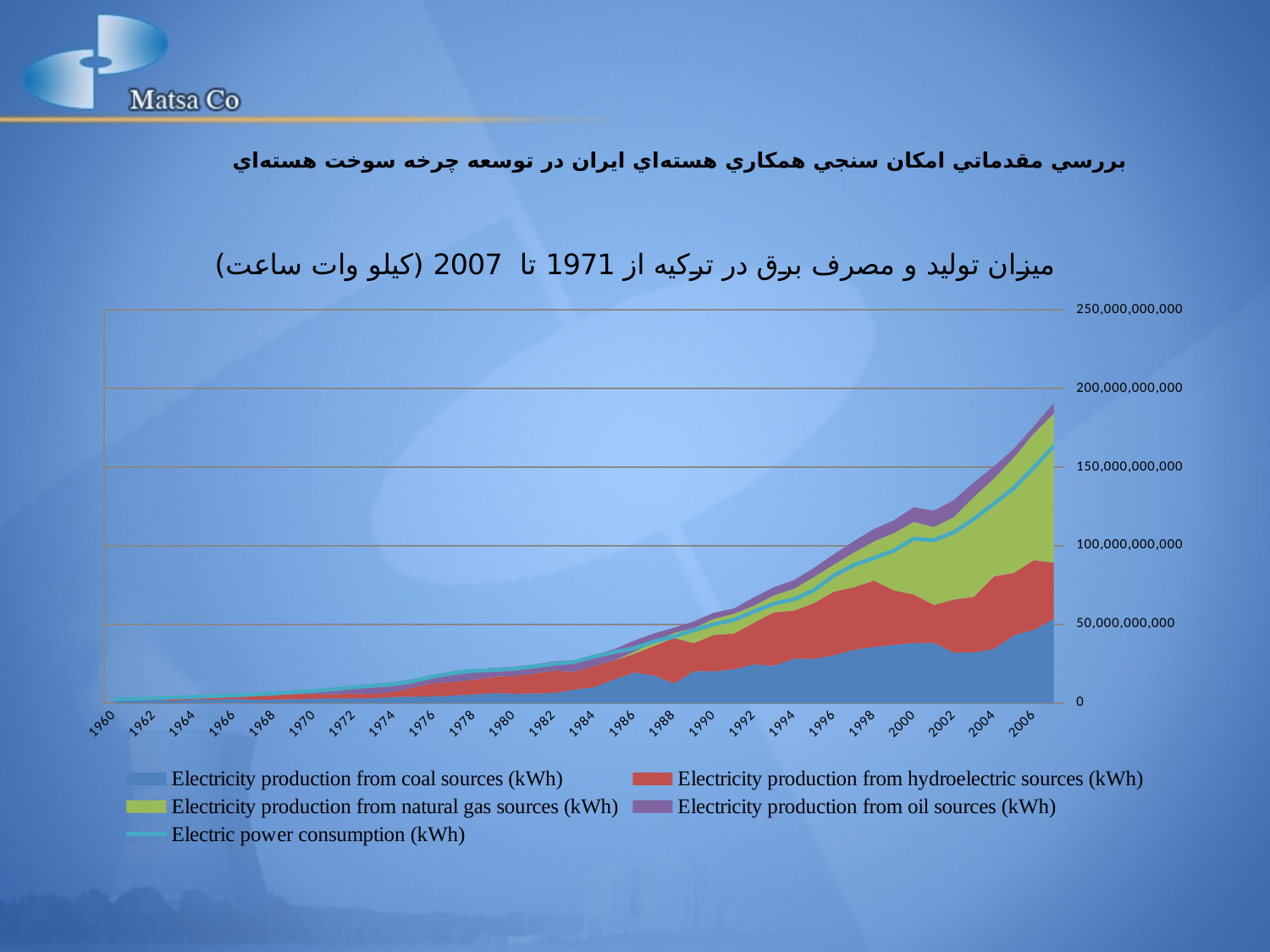
In 2006, which contributes more: Electricity production from natural gas sources (kWh) or Electricity production from oil sources (kWh)? Electricity production from natural gas sources (kWh) How many year labels are shown along the x axis? 24 Which production source has the smallest contribution in 2006? Electricity production from oil sources (kWh) Is the total stacked electricity production in 1980 greater or less than 50,000,000,000? less How many series does the legend list? 5 What kind of chart is shown on the slide? area chart Is the total stacked electricity production in 2006 greater or less than 200,000,000,000? less Which series is drawn as a line rather than a filled area? Electric power consumption (kWh) What is the highest value labelled on the y axis? 250,000,000,000 Is the value of Electric power consumption (kWh) in 1980 greater or less than 50,000,000,000? less Does Electric power consumption (kWh) rise or fall from 1960 to 2006? rise